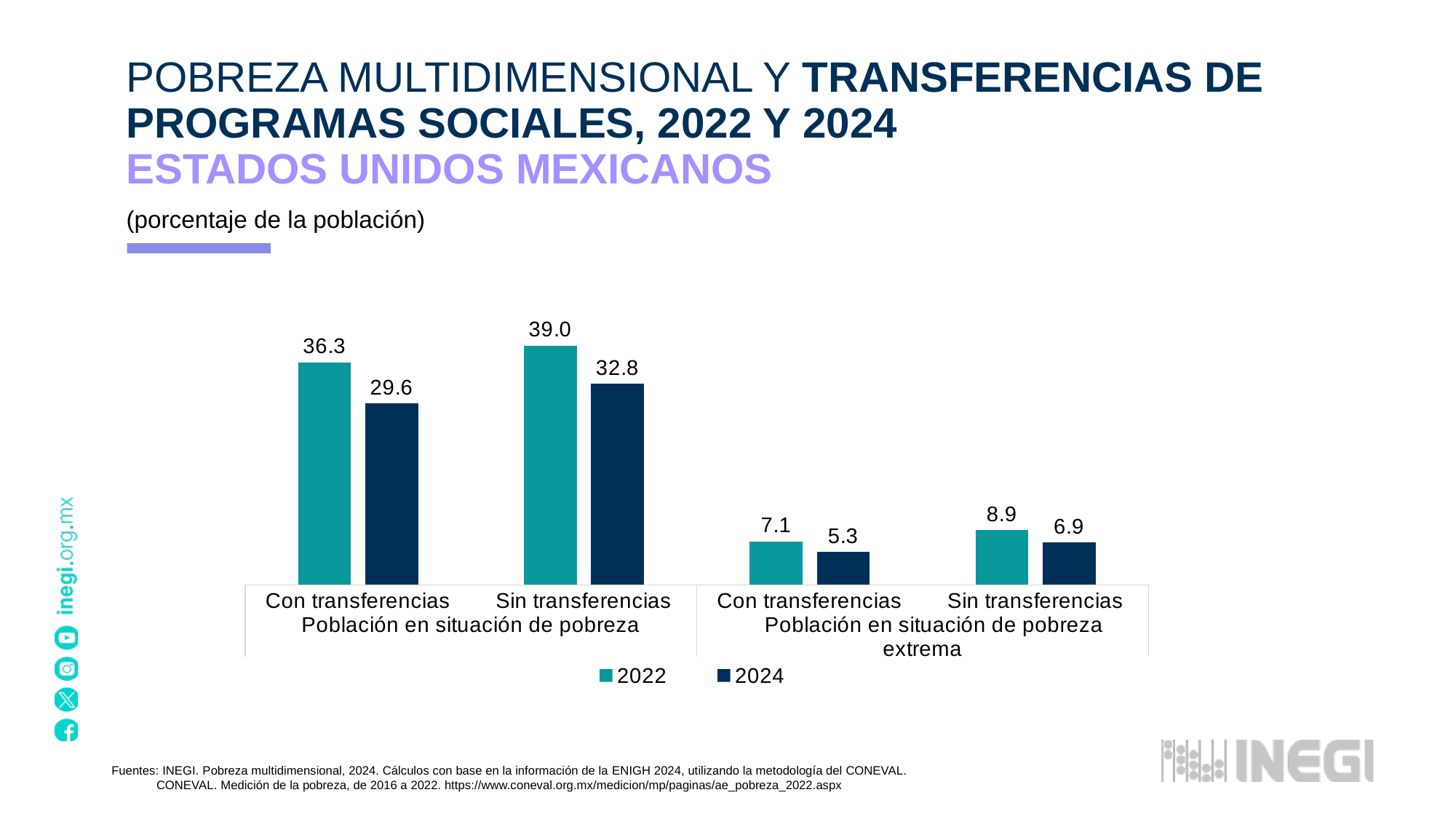
What is the 2024 value for 'Con transferencias' under 'Población en situación de pobreza extrema'? 5.3 Which bar has the highest value in the chart? Sin transferencias, Población en situación de pobreza, 2022 What is the 2022 value for 'Sin transferencias' under 'Población en situación de pobreza extrema'? 8.9 How many series does the legend list? 2 Which is larger: the 2024 value for 'Sin transferencias' in 'Población en situación de pobreza' or the 2022 value for 'Con transferencias' in the same group? 2022 value for Con transferencias (36.3) What is the 2024 value for 'Sin transferencias' under 'Población en situación de pobreza'? 32.8 Which colour represents the 2024 series in the chart? Dark navy blue What is the difference between the 2022 and 2024 values for 'Con transferencias' under 'Población en situación de pobreza'? 6.7 What is the 2022 value for 'Con transferencias' under 'Población en situación de pobreza'? 36.3 What is the difference between the 2022 and 2024 values for 'Sin transferencias' under 'Población en situación de pobreza extrema'? 2.0 Which bar has the lowest value in the chart? Con transferencias, Población en situación de pobreza extrema, 2024 What kind of chart is shown on the slide? Bar chart